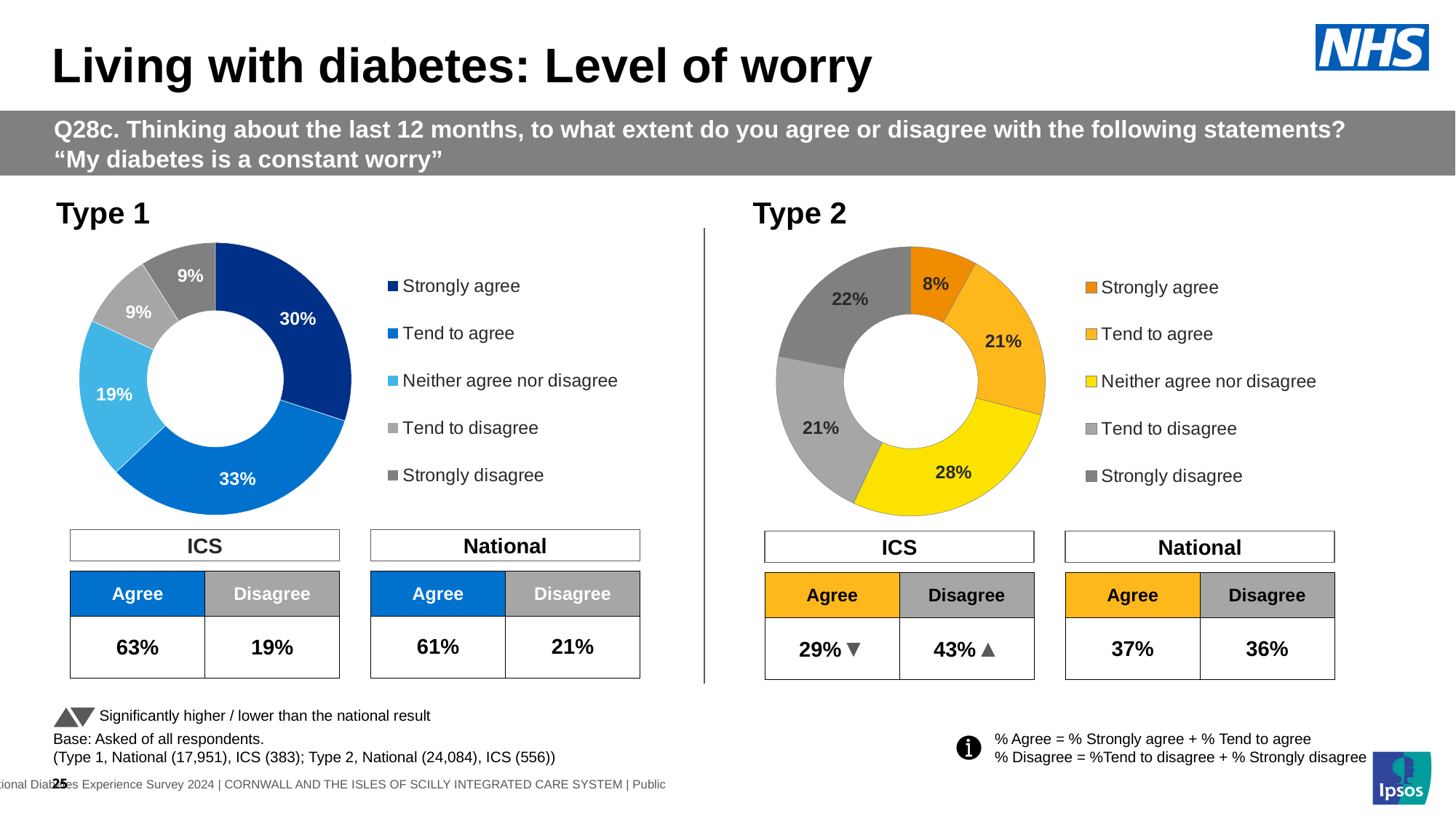
In the Type 1 chart, what percentage of respondents said they tend to agree? 33% In the Type 1 chart, which response category has the largest share? Tend to agree In the Type 2 chart, which response category has the smallest share? Strongly agree In the Type 1 chart, what colour is the Strongly agree segment? Dark blue In the Type 1 chart, what percentage of respondents said they strongly agree? 30% What kind of chart is used to show the Type 2 results? Donut (pie) chart In the Type 2 chart, what percentage of respondents said they strongly disagree? 22% In the Type 2 chart, which is larger: the Strongly agree share or the Strongly disagree share? Strongly disagree In the Type 2 chart, what percentage of respondents said they neither agree nor disagree? 28% In the Type 1 chart, what is the difference between the Tend to agree share and the Neither agree nor disagree share? 14 percentage points How many response categories does the legend of the Type 1 chart list? 5 In the Type 2 chart, which response category has the largest share? Neither agree nor disagree